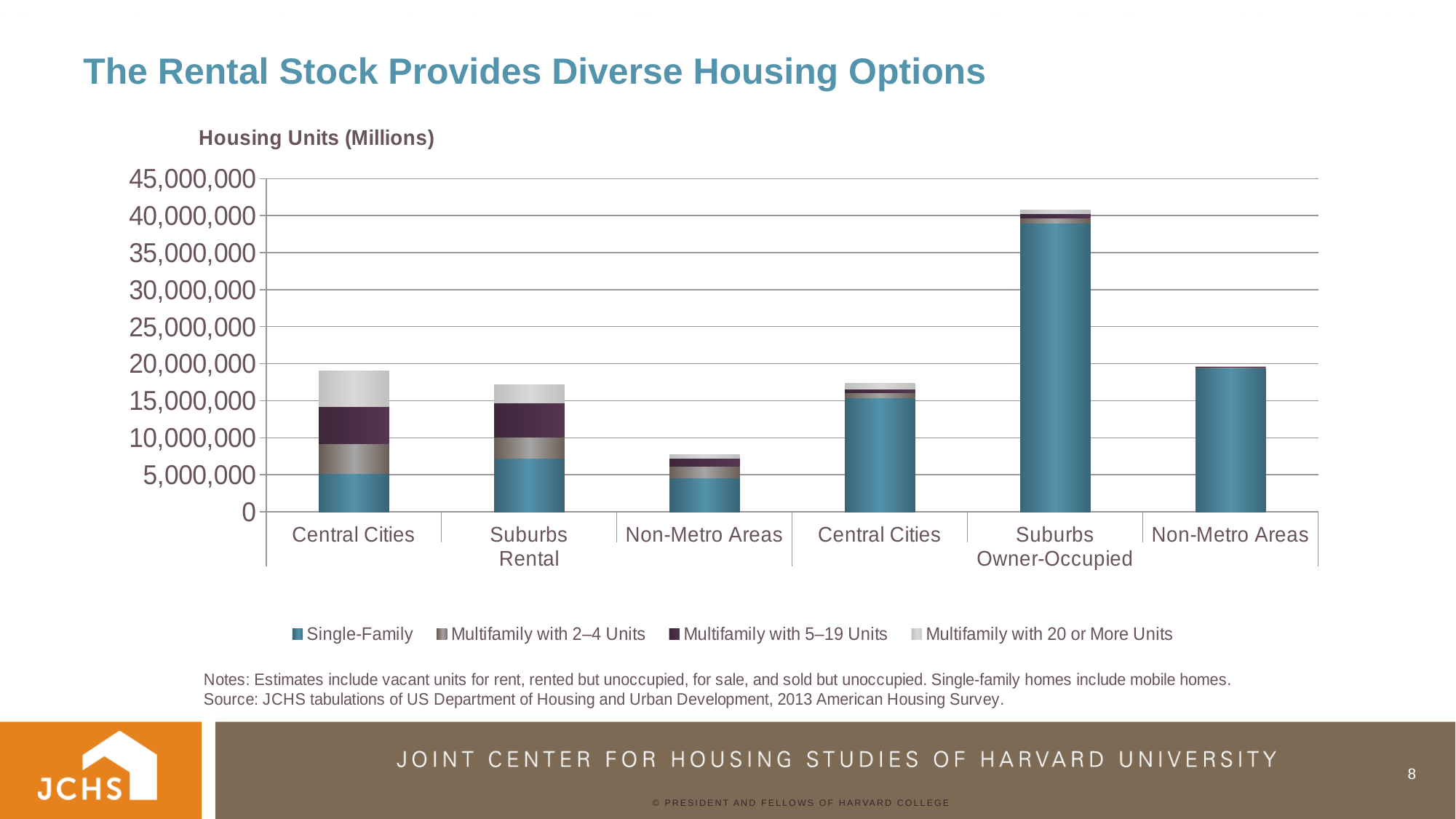
Is the total for Suburbs Owner-Occupied greater or less than 35,000,000? greater What is the label shown above the vertical axis of the chart? Housing Units (Millions) Is the total for Central Cities Rental greater or less than 15,000,000? greater Which legend entry is shown in the lightest grey colour? Multifamily with 20 or More Units Which bar has the lowest total housing units? Non-Metro Areas (Rental) Is the total for Non-Metro Areas Rental greater or less than 10,000,000? less Which bar has the highest total housing units? Suburbs (Owner-Occupied) How many series does the legend list? 4 How many bars (categories) are plotted in the chart? 6 Which has a larger total: Central Cities Rental or Suburbs Rental? Central Cities Rental What kind of chart is shown on the slide? Stacked bar chart Which has a larger total: Central Cities Owner-Occupied or Non-Metro Areas Owner-Occupied? Non-Metro Areas Owner-Occupied